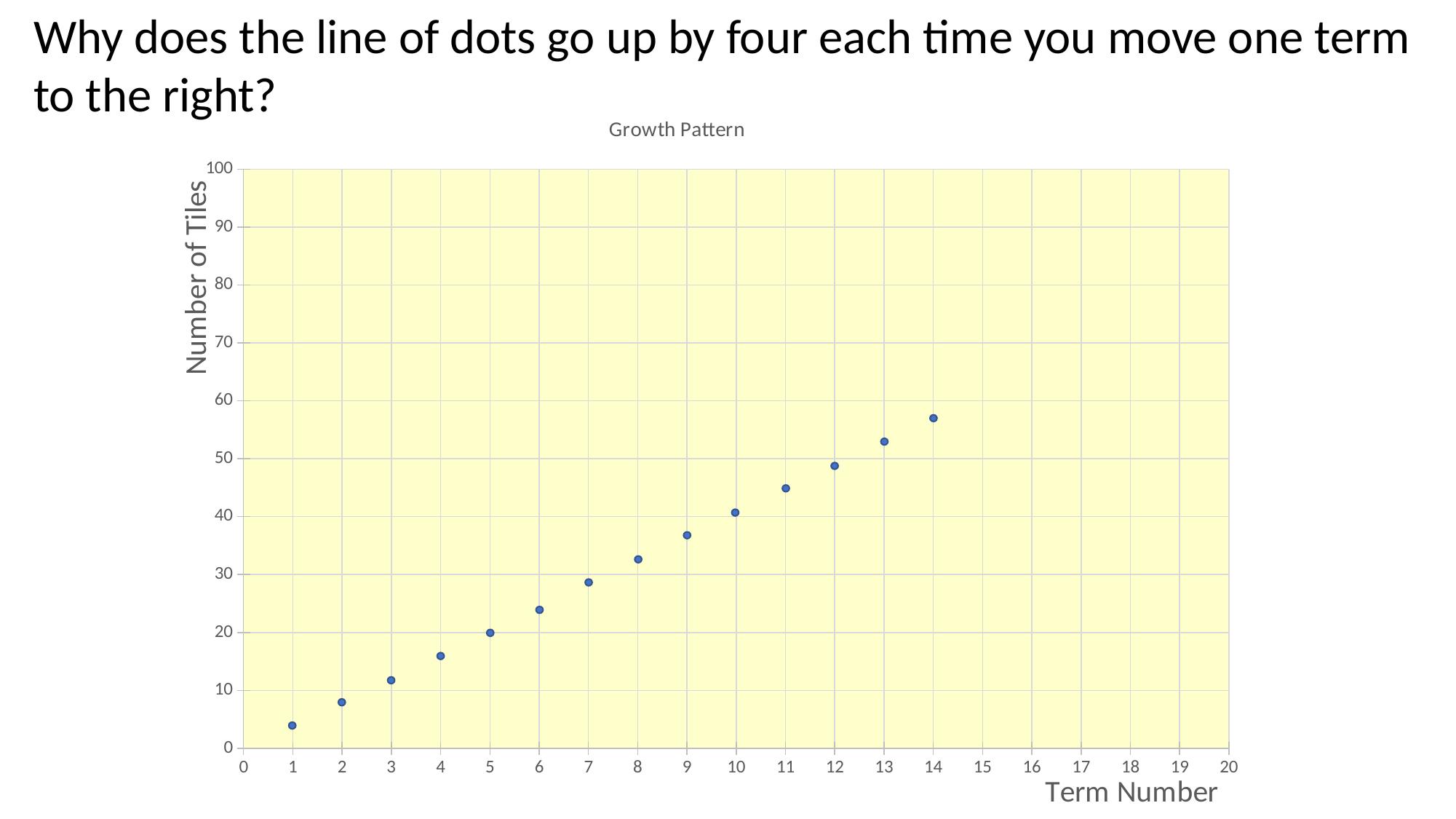
Which has more tiles, term number 8 or term number 12? term number 12 Which term number has the lowest number of tiles? 1 What is the title of the chart? Growth Pattern Is the number of tiles for term number 1 greater or less than 10? less Is the number of tiles for term number 9 greater or less than 40? less Is the number of tiles for term number 14 greater or less than 50? greater Which term number has the highest number of tiles? 14 What is the label on the vertical axis of the chart? Number of Tiles How many data points are plotted on the chart? 14 What kind of chart is shown on the slide? scatter plot Do the values rise or fall as the term number increases? rise What is the number of tiles for term number 5? 20